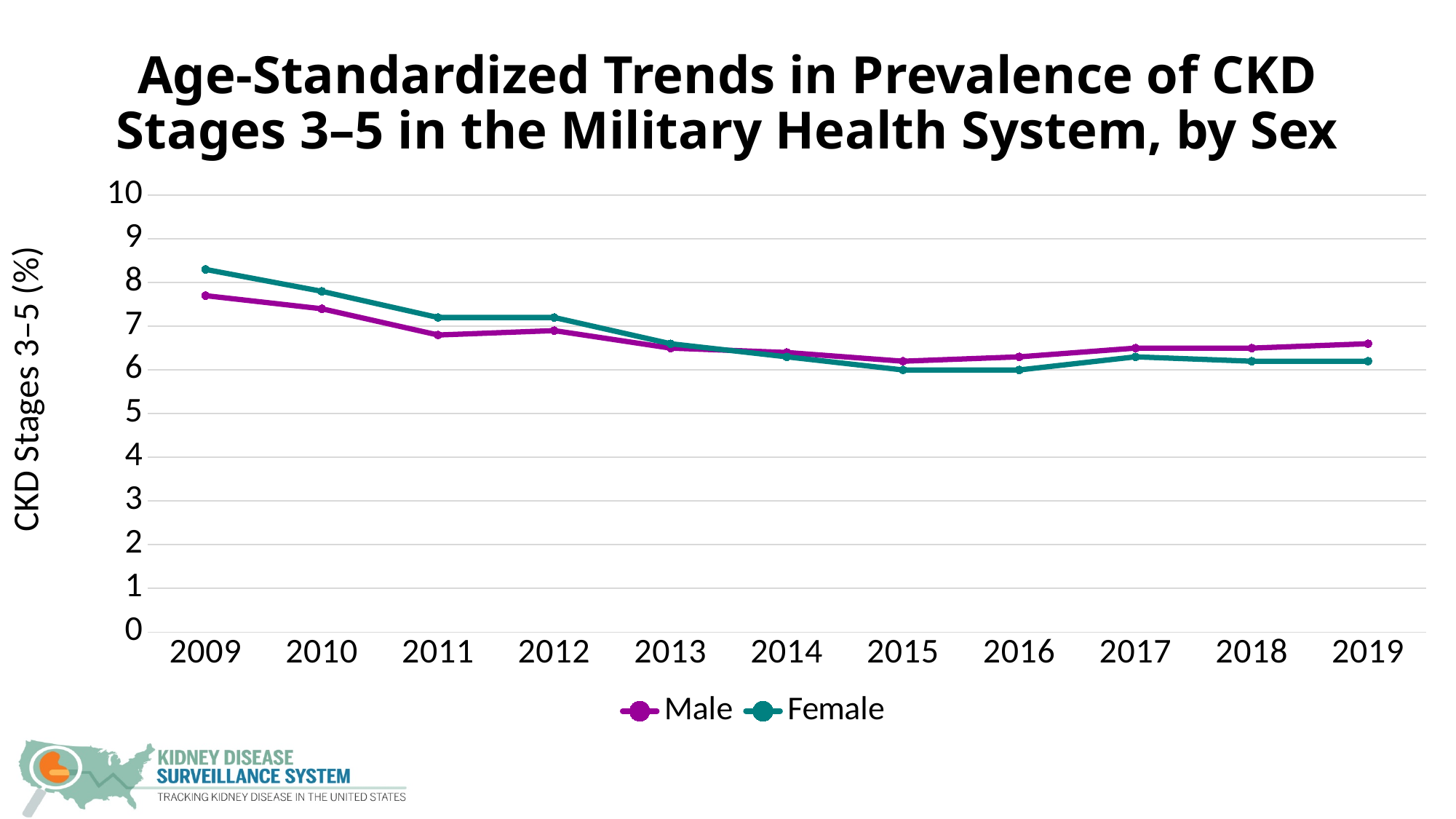
Is the Female value for 2009 greater or less than 8? greater Is the Male value for 2011 greater or less than 7? less In 2009, which series has the higher value, Male or Female? Female Is the Male value for 2019 greater or less than 7? less What kind of chart is shown on the slide? line chart In which year is the Female series at its highest? 2009 How many years are plotted along the x axis? 11 Does the Female series rise or fall from 2009 to 2015? fall In 2019, which series has the higher value, Male or Female? Male How many series does the legend list? 2